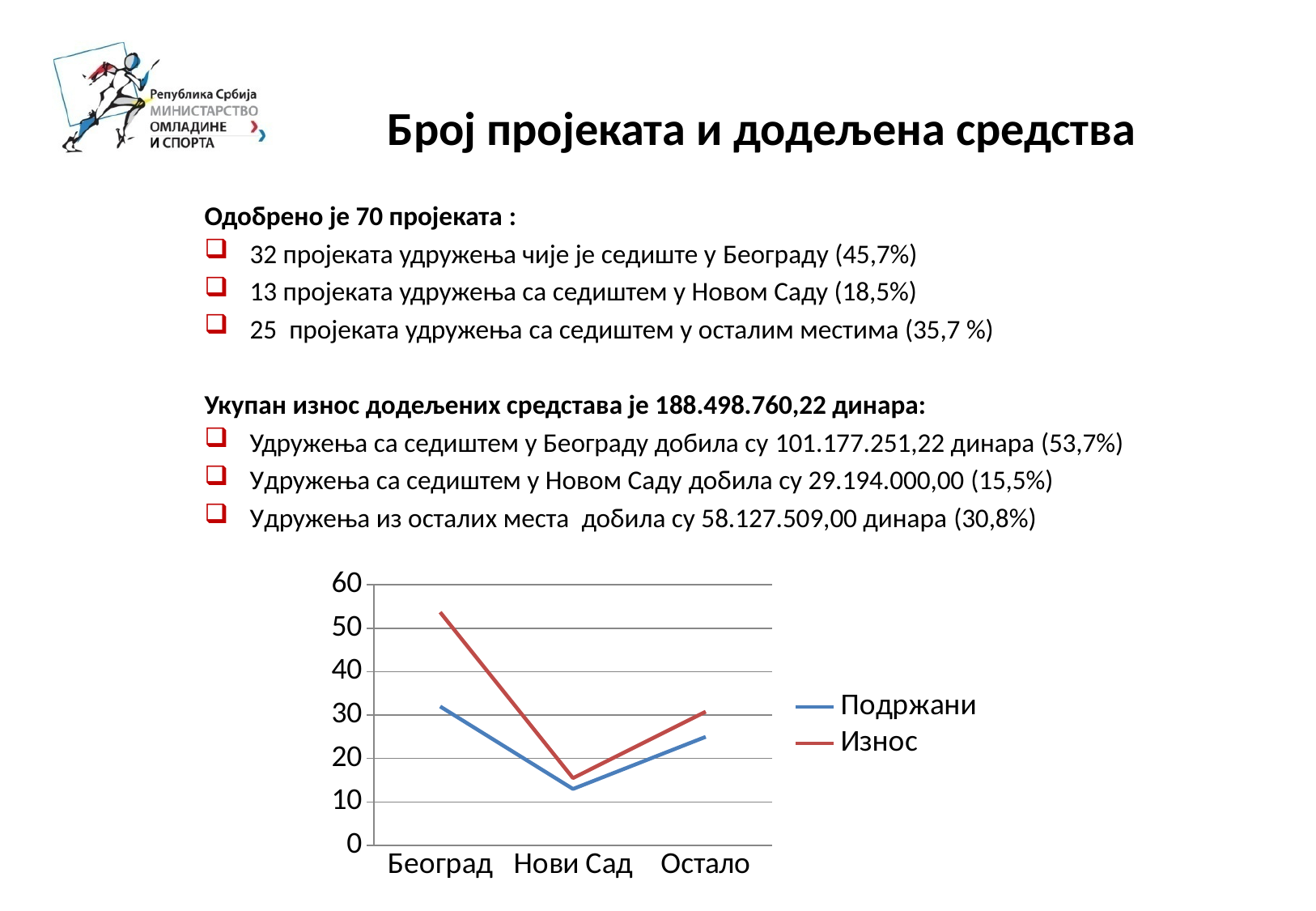
For Београд, which series has the larger value, Подржани or Износ? Износ Which category has the highest value for the Износ series? Београд What kind of chart is shown on the slide? line chart Is the value for Остало in the Износ series greater or less than 40? less How many categories are shown on the x axis of the chart? 3 Does the Подржани series rise or fall from Београд to Нови Сад? fall Is the value for Нови Сад in the Подржани series greater or less than 20? less Is the value for Београд in the Износ series greater or less than 50? greater Which category has the lowest value for the Износ series? Нови Сад Which category has the lowest value for the Подржани series? Нови Сад How many series does the chart legend list? 2 What colour is the line for the Износ series? red